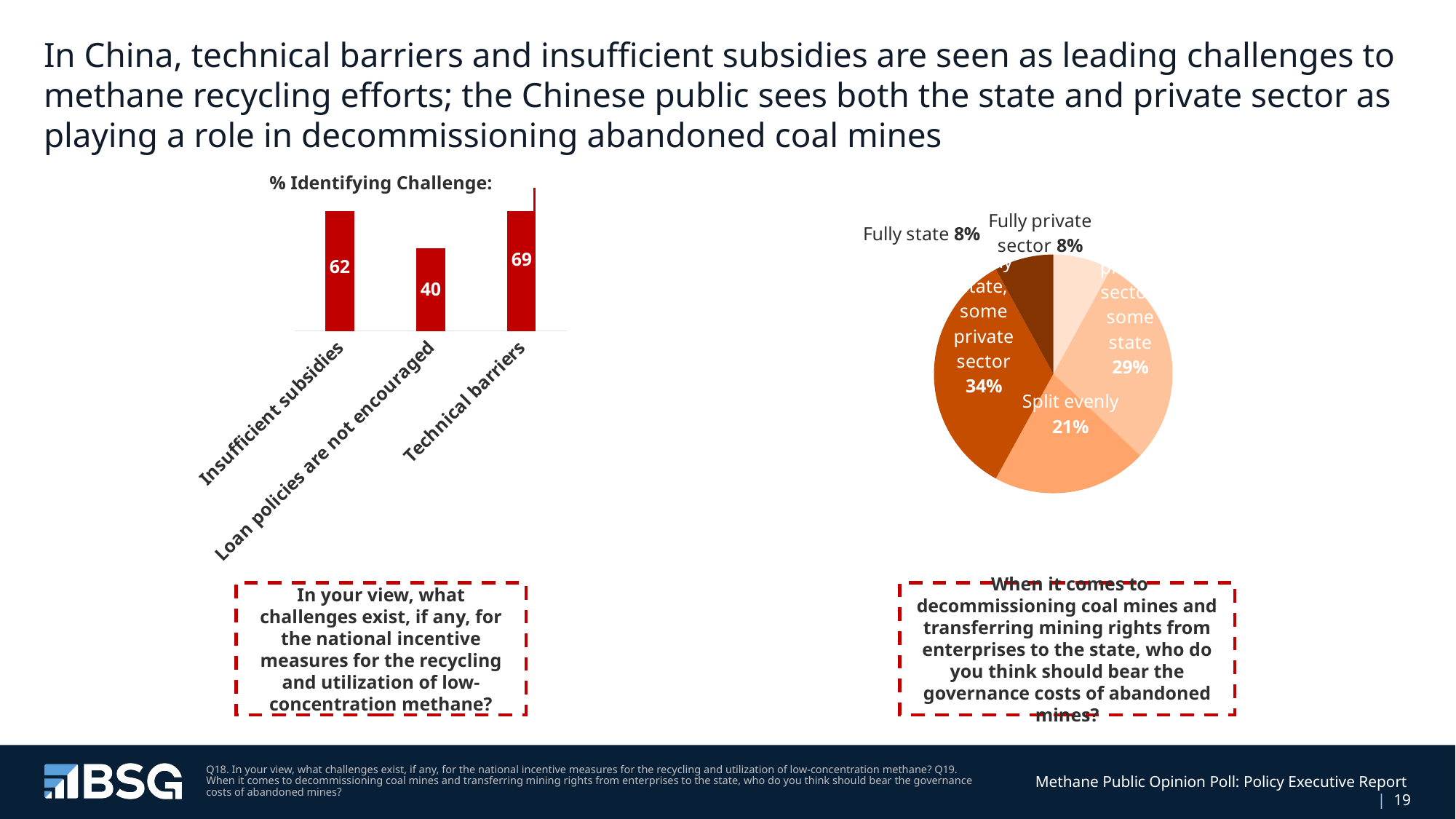
In the pie chart on the right, what share of respondents chose 'Split evenly'? 21% In the '% Identifying Challenge' bar chart, how many challenges are shown? 3 In the '% Identifying Challenge' bar chart, what is the difference between the values for technical barriers and insufficient subsidies? 7 In the '% Identifying Challenge' bar chart, which challenge has the highest value? Technical barriers In the pie chart on the right, how many slices are there? 5 In the pie chart on the right, what share of respondents chose 'Fully state'? 8% In the pie chart on the right, is the share for 'Mostly private sector, some state' larger or smaller than the share for 'Split evenly'? Larger In the '% Identifying Challenge' bar chart, what is the value for 'Loan policies are not encouraged'? 40 In the pie chart on the right, which option has the largest share? Mostly state, some private sector What type of chart is the '% Identifying Challenge' chart on the left? Bar chart In the '% Identifying Challenge' bar chart, what percentage identified technical barriers as a challenge? 69 In the '% Identifying Challenge' bar chart, which challenge has the lowest value? Loan policies are not encouraged